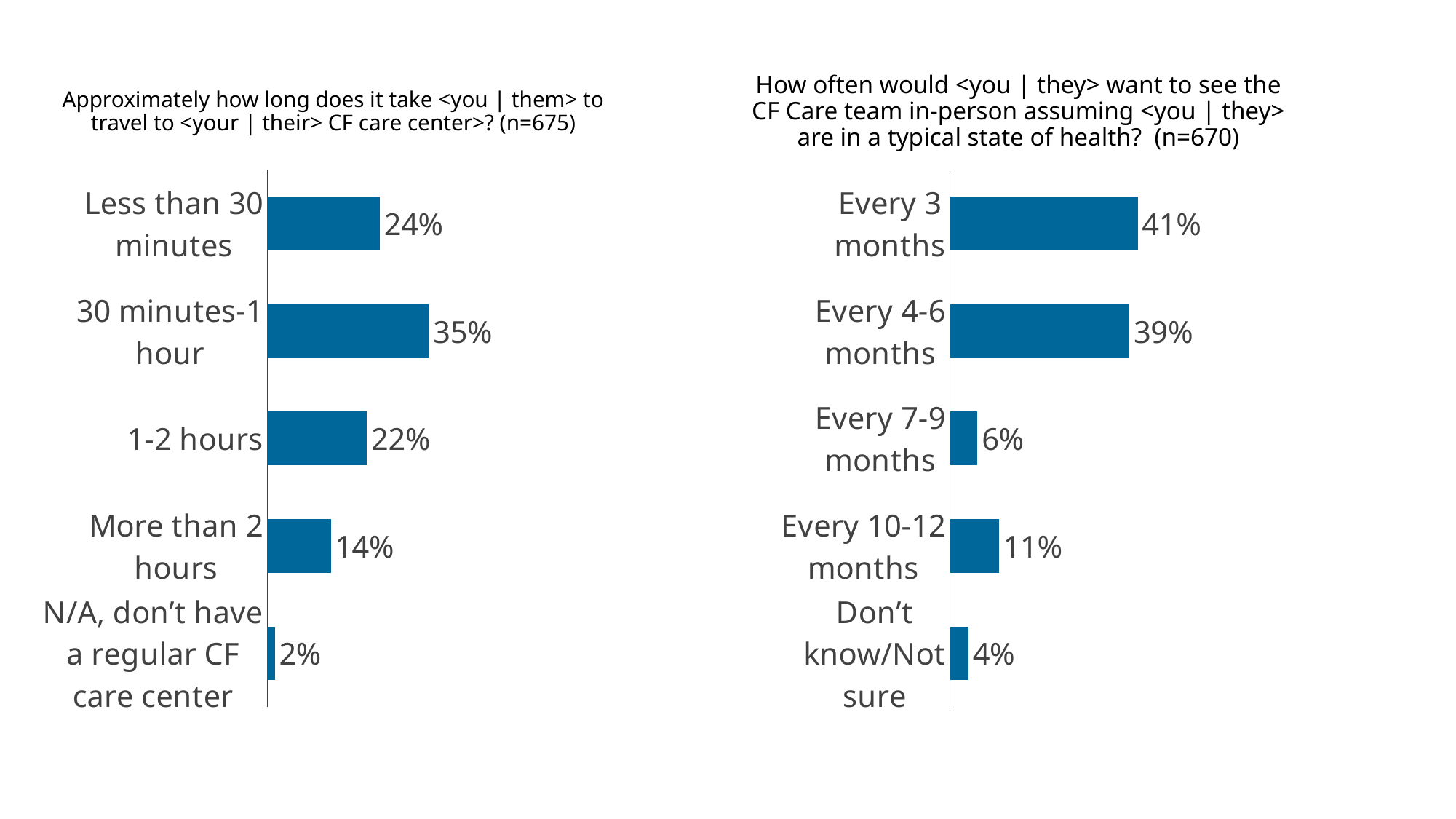
In the right chart (how often to see the CF Care team in-person), what percentage of respondents chose 'Every 3 months'? 41% In the right chart (how often to see the CF Care team in-person), what percentage of respondents chose 'Every 10-12 months'? 11% In the left chart (travel time to CF care center), which category has the lowest value? N/A, don't have a regular CF care center In the left chart (travel time to CF care center), which category has the highest value? 30 minutes-1 hour In the left chart (travel time to CF care center), how many categories are shown? 5 In the right chart (how often to see the CF Care team in-person), what is the difference between 'Every 3 months' and 'Every 4-6 months'? 2% In the left chart (travel time to CF care center), what is the difference between the values for 'Less than 30 minutes' and '1-2 hours'? 2% In the right chart (how often to see the CF Care team in-person), which category has the lowest value? Don't know/Not sure In the left chart (travel time to CF care center), what percentage of respondents take 30 minutes-1 hour? 35% In the left chart (travel time to CF care center), what percentage of respondents take more than 2 hours? 14% What kind of chart is the right chart (how often to see the CF Care team in-person)? Bar chart In the right chart (how often to see the CF Care team in-person), which is larger: 'Every 7-9 months' or 'Every 10-12 months'? Every 10-12 months